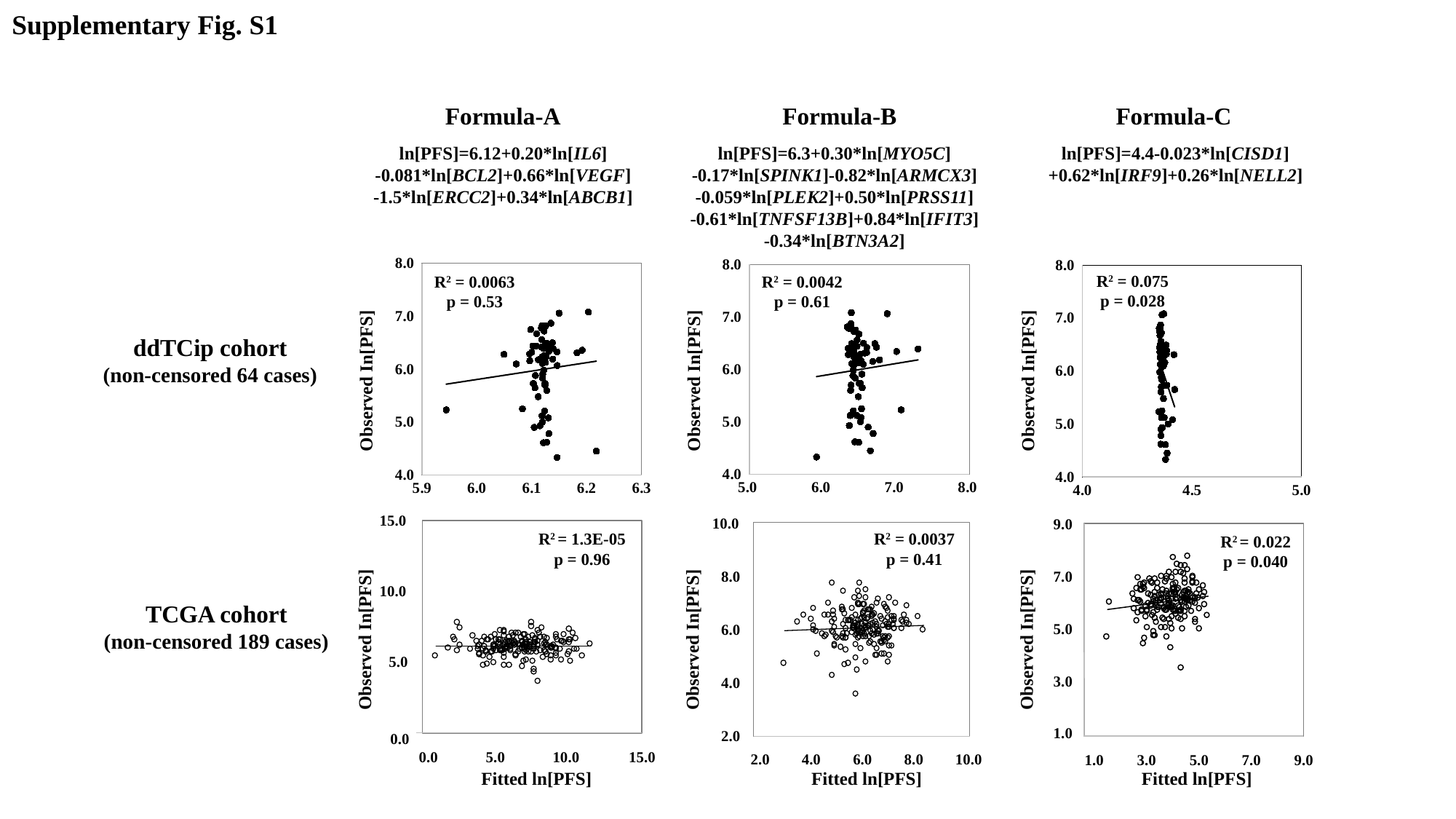
In the ddTCip cohort, is the p value for Formula-A or Formula-B larger? Formula-B In the ddTCip cohort, what is the difference between the p values for Formula-B and Formula-A? 0.08 In the TCGA cohort chart for Formula-B, what is the p value shown? 0.41 What kind of chart is used in each panel of this figure? Scatter chart In the ddTCip cohort chart for Formula-C, what is the R² value shown? 0.075 In the TCGA cohort chart for Formula-A, what is the R² value shown? 1.3E-05 Among the three ddTCip cohort charts, which formula has the highest R² value? Formula-C How many charts are shown on the slide? 6 In the TCGA cohort chart for Formula-C, what is the p value shown? 0.040 Among the three TCGA cohort charts, which formula has the lowest p value? Formula-C In the ddTCip cohort chart for Formula-B, what is the p value shown? 0.61 In the ddTCip cohort chart for Formula-A, what is the R² value shown? 0.0063